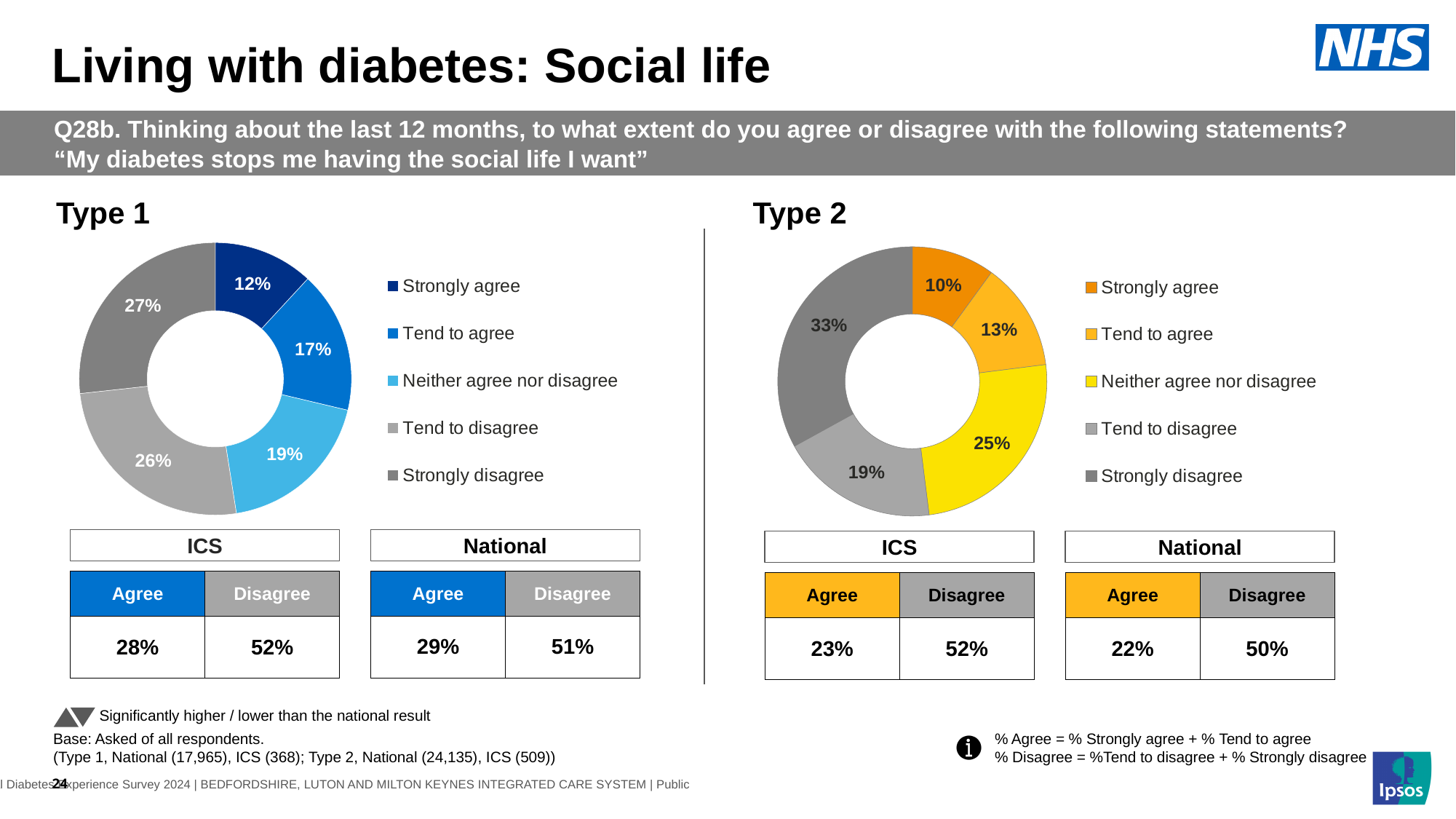
In the Type 2 chart, what colour is the 'Strongly agree' segment? Orange In the Type 1 chart, what is the difference in percentage points between 'Strongly disagree' and 'Strongly agree'? 15 In the Type 2 chart, what percentage of respondents said they tend to agree? 13% In the Type 1 chart, what percentage of respondents said they tend to disagree? 26% In the Type 2 chart, which is larger: the share for 'Neither agree nor disagree' or the share for 'Tend to disagree'? Neither agree nor disagree In the Type 2 chart, which response category has the largest share? Strongly disagree In the Type 1 chart, what percentage of respondents said they strongly agree? 12% In the Type 2 chart, what percentage of respondents said they neither agree nor disagree? 25% What kind of chart is used for the Type 2 data? Donut (pie) chart In the Type 1 chart, which response category has the smallest share? Strongly agree How many response categories does the legend of the Type 1 chart list? 5 In the Type 2 chart, which response category has the smallest share? Strongly agree